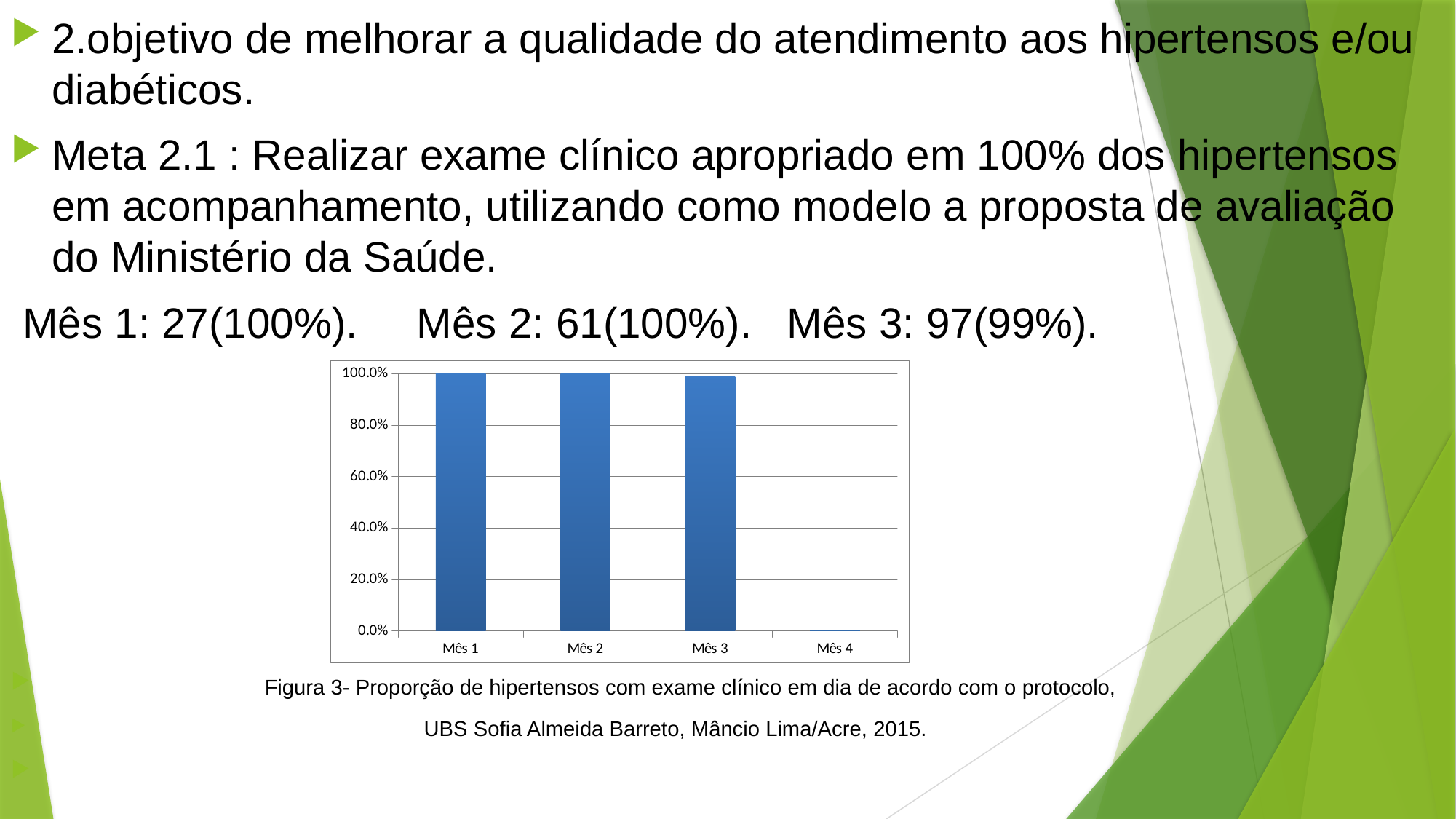
Does the value rise or fall from Mês 3 to Mês 4? fall Which is larger, the value for Mês 3 or the value for Mês 4? Mês 3 What is the highest tick value shown on the y axis of the chart? 100.0% Is the value for Mês 4 greater or less than 20.0%? less What is the value for Mês 1 in the chart? 100.0% What kind of chart is shown on the slide? bar chart What colour are the bars in the chart? blue Which category has the lowest value in the chart? Mês 4 Is the value for Mês 3 greater or less than 80.0%? greater How many categories are shown on the x axis of the chart? 4 What is the value for Mês 2 in the chart? 100.0%